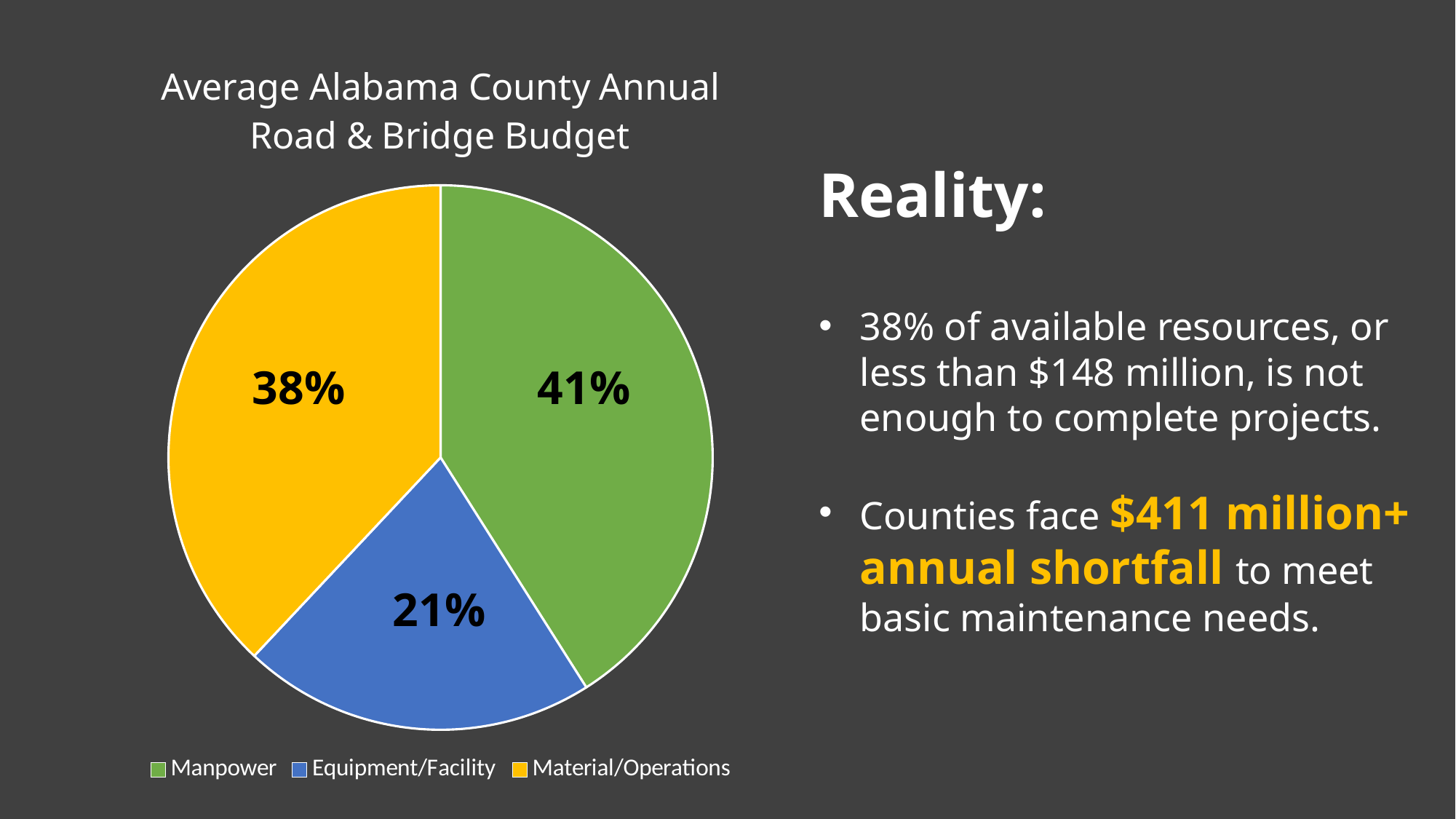
Which colour represents Equipment/Facility in the chart? Blue Which category has the largest share of the budget? Manpower What kind of chart is shown on the slide? Pie chart Which is larger, the Manpower share or the Material/Operations share? Manpower What is the difference in percentage points between the Material/Operations and Equipment/Facility shares? 17 How many categories does the pie chart show? 3 Which category has the smallest share of the budget? Equipment/Facility What share of the budget is Equipment/Facility? 21% What share of the budget is Material/Operations? 38% What share of the Average Alabama County Annual Road & Bridge Budget goes to Manpower? 41% What is the difference in percentage points between the Manpower and Equipment/Facility shares? 20 What is the title of the chart? Average Alabama County Annual Road & Bridge Budget